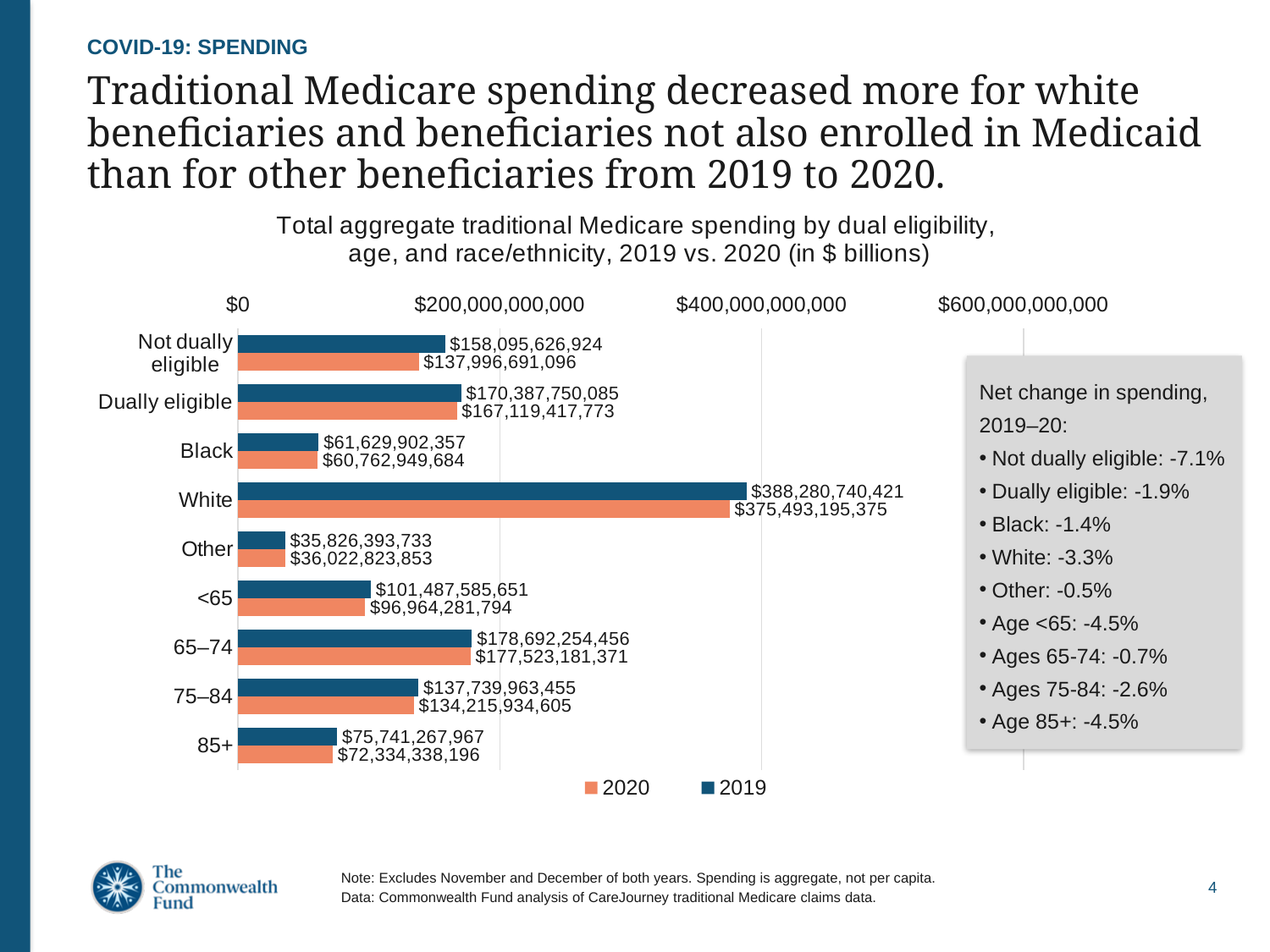
Is the 2019 spending value for White beneficiaries greater or less than $200,000,000,000? greater What is the difference between 2019 and 2020 spending for beneficiaries not dually eligible? $20,098,935,828 What was traditional Medicare spending for beneficiaries aged 85+ in 2020? $72,334,338,196 What kind of chart is shown on the slide? Bar chart Which series is shown in orange in the legend? 2020 Which category had the lowest spending in 2020? Other How many series does the legend list? 2 What was traditional Medicare spending for White beneficiaries in 2019? $388,280,740,421 What was traditional Medicare spending for dually eligible beneficiaries in 2020? $167,119,417,773 Which is larger for the Other category: spending in 2019 or in 2020? 2020 How many categories are plotted on the chart? 9 Which category had the highest spending in 2019? White